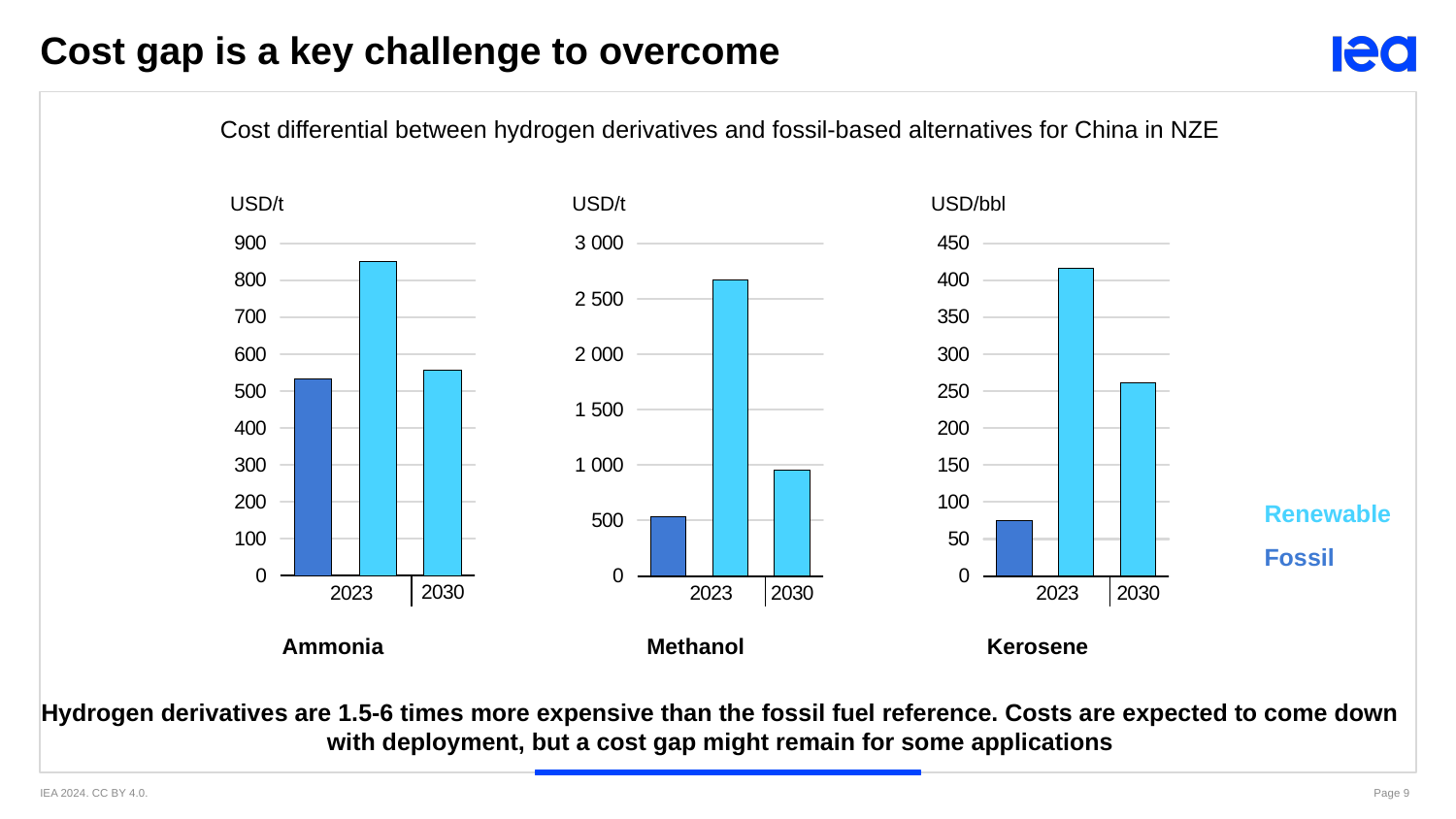
How many series does the legend list? 2 In the Methanol chart, which bar is the lowest? Fossil 2023 In the Ammonia chart, is the Renewable 2023 value greater or less than 800? greater What kind of chart is used for Ammonia, Methanol and Kerosene on this slide? Bar chart In the Kerosene chart, which is larger: the Renewable 2030 value or the Fossil 2023 value? Renewable 2030 In the Kerosene chart, is the Renewable 2023 value greater or less than 400? greater What are the two series named in the legend? Renewable and Fossil In the Ammonia chart, which bar is the highest? Renewable 2023 In the Kerosene chart, does the Renewable value rise or fall from 2023 to 2030? Fall In the Ammonia chart, is the Fossil 2023 value greater or less than 600? less